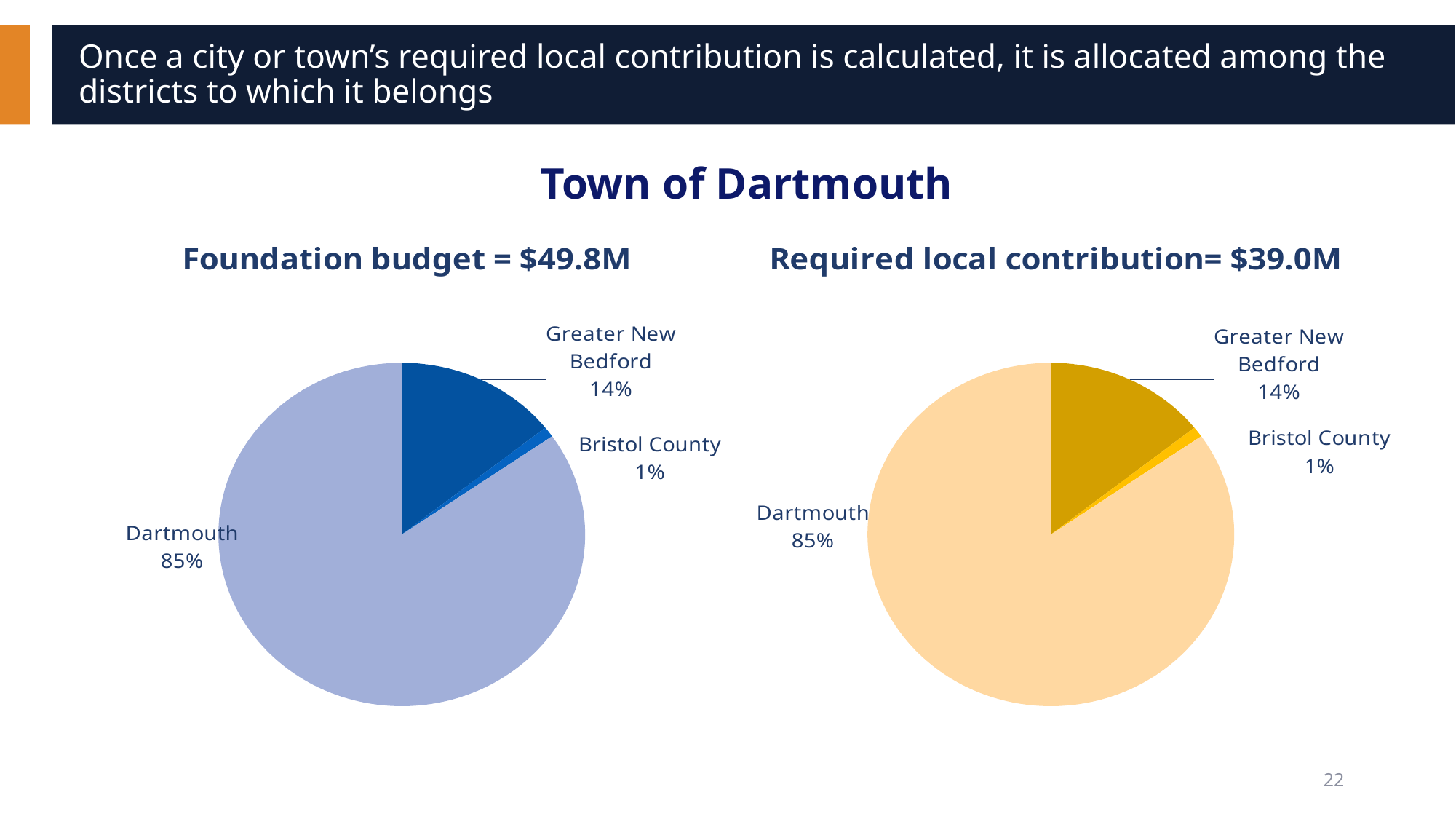
In the Foundation budget pie chart, what share does Greater New Bedford have? 14% In the Required local contribution pie chart, which slice is the smallest? Bristol County In the Required local contribution pie chart, which is larger: Greater New Bedford or Bristol County? Greater New Bedford In the Required local contribution pie chart, what share does Bristol County have? 1% In the Foundation budget pie chart, what is the difference in percentage points between Dartmouth and Greater New Bedford? 71 percentage points What type of chart is used for the Required local contribution? Pie chart What is the title of the left chart? Foundation budget = $49.8M How many slices does the Foundation budget pie chart have? 3 In the Foundation budget pie chart, what share does Dartmouth have? 85% In the Required local contribution pie chart, what share does Greater New Bedford have? 14% In the Foundation budget pie chart, which slice is the largest? Dartmouth What is the title of the right chart? Required local contribution= $39.0M